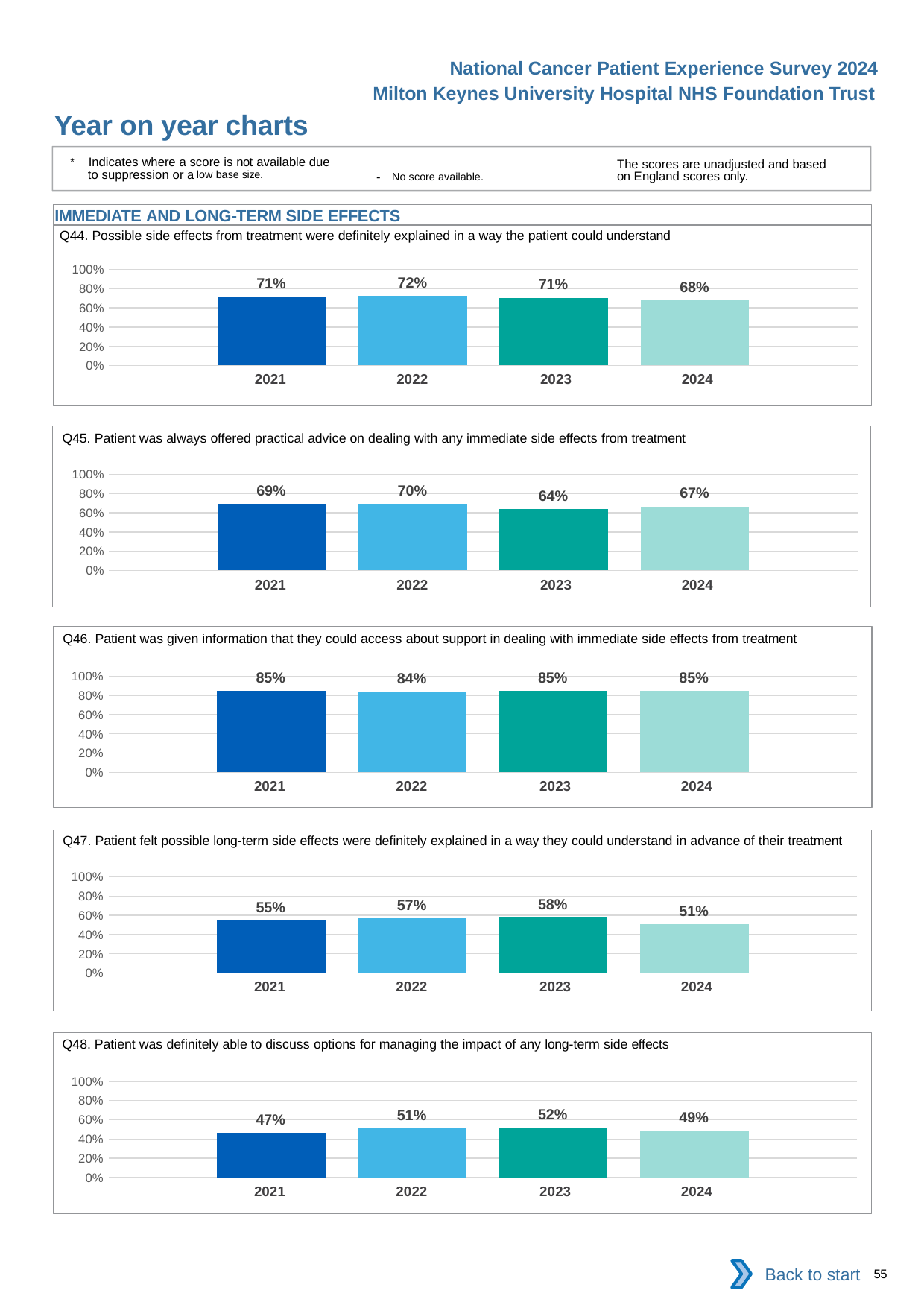
What type of chart is the Q47 chart? Bar chart In the Q47 chart, what is the value for 2021? 55% In the Q48 chart, which year has the highest value? 2023 In the Q45 chart, is the value for 2022 larger than the value for 2024? Yes In the Q44 chart, what is the value for 2022? 72% In the Q48 chart, is the value for 2021 greater or less than 60%? less In the Q46 chart, what is the value for 2022? 84% In the Q44 chart, what is the difference between the 2021 and 2024 values? 3% In the Q47 chart, what is the difference between the 2023 and 2024 values? 7% In the Q45 chart, which year has the lowest value? 2023 What is the section heading above the Q44 chart? IMMEDIATE AND LONG-TERM SIDE EFFECTS How many years are shown in the Q44 chart? 4